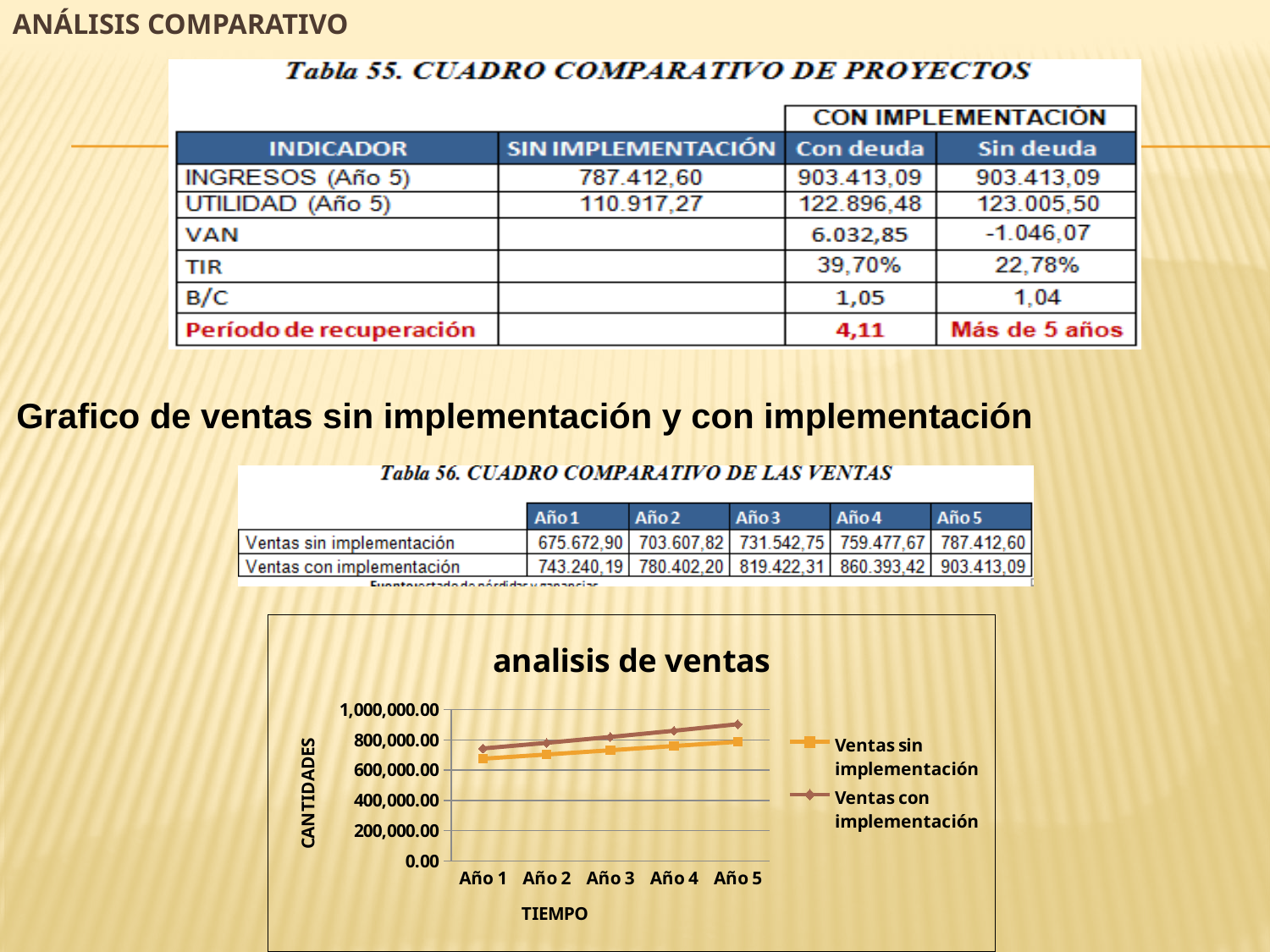
How many points along the x axis does each series in the "analisis de ventas" chart have? 5 What kind of chart is the "analisis de ventas" chart? line chart In the "analisis de ventas" chart, is the value for Ventas con implementación in Año 1 greater or less than 600,000.00? greater In the "analisis de ventas" chart, is the value for Ventas sin implementación in Año 1 greater or less than 800,000.00? less How many series does the legend of the "analisis de ventas" chart list? 2 In the "analisis de ventas" chart, which series has the larger value in Año 3, Ventas sin implementación or Ventas con implementación? Ventas con implementación What is the label on the horizontal axis of the "analisis de ventas" chart? TIEMPO What is the label on the vertical axis of the "analisis de ventas" chart? CANTIDADES In the "analisis de ventas" chart, do the values for Ventas con implementación rise or fall from Año 1 to Año 5? rise In the "analisis de ventas" chart, is the value for Ventas con implementación in Año 4 greater or less than 800,000.00? greater In the "analisis de ventas" chart, in which year is Ventas con implementación highest? Año 5 In the "analisis de ventas" chart, in which year is Ventas sin implementación lowest? Año 1